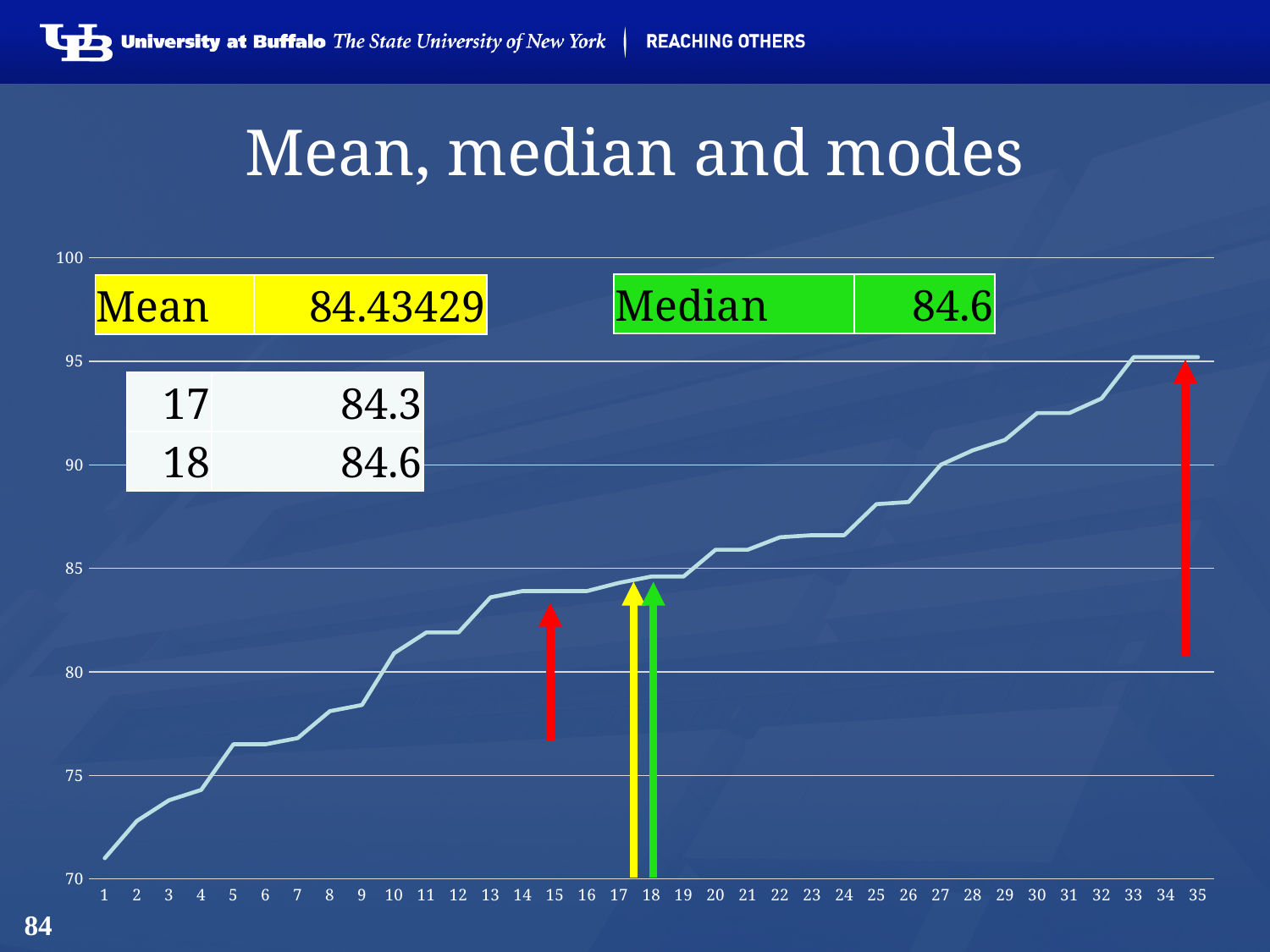
Is the value for point 30 greater or less than 90? greater Which point on the x axis has the highest value? 33, 34 and 35 (tied) What median value is shown on the slide? 84.6 What kind of chart is shown on the slide? line chart Which point on the x axis has the lowest value? 1 What is the difference between the values for points 18 and 17? 0.3 What is the value for point 17 according to the table on the slide? 84.3 What is the value for point 18 according to the table on the slide? 84.6 What mean value is shown on the slide? 84.43429 Is the value for point 1 greater or less than 75? less How many data points are plotted along the x axis? 35 Do the plotted values rise or fall as the x axis goes from 1 to 35? rise